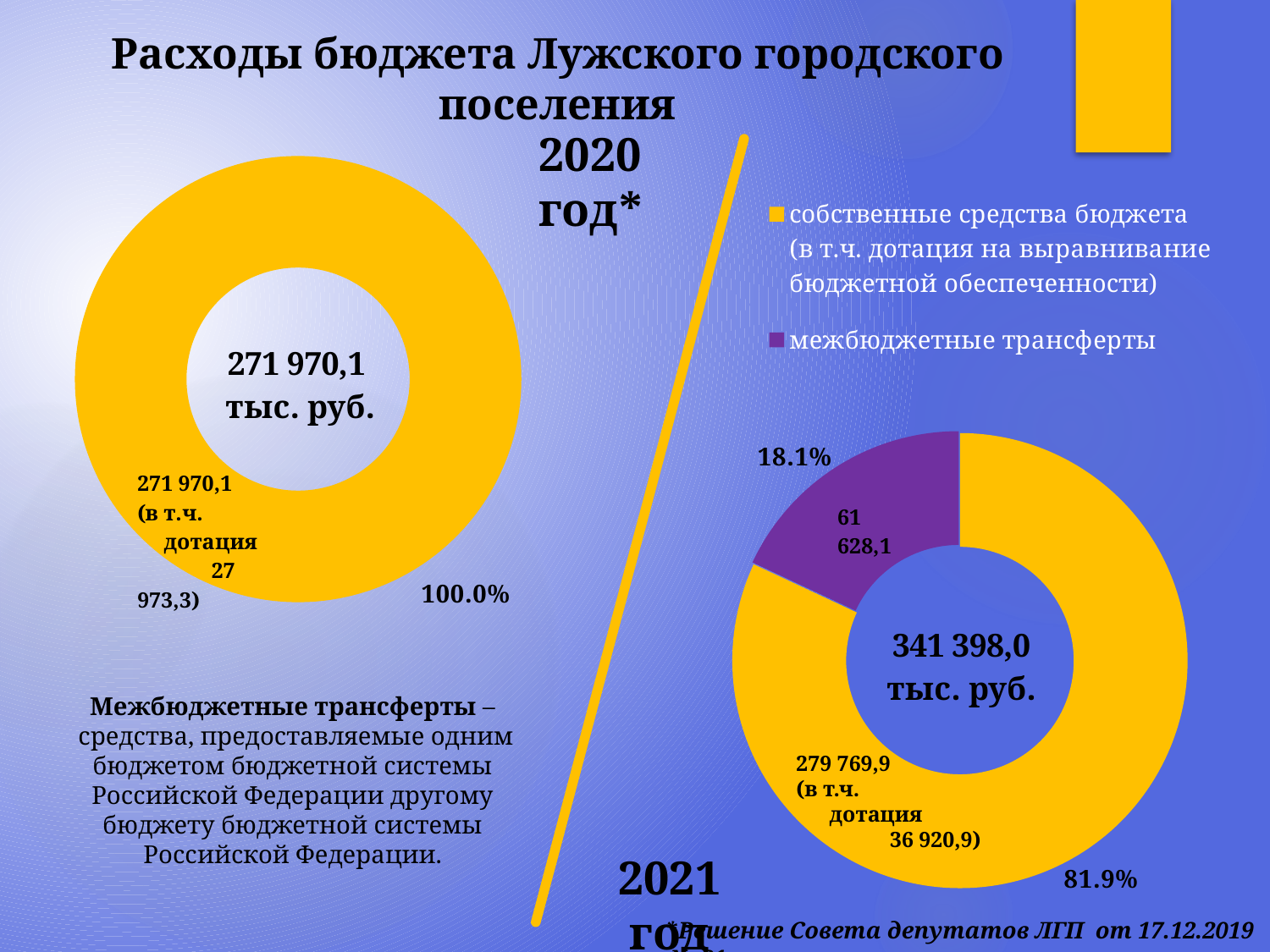
In the 2021 год chart on the right, what is the value for межбюджетные трансферты? 61 628,1 In the 2021 год chart on the right, which category is larger: собственные средства бюджета or межбюджетные трансферты? собственные средства бюджета How many series does the legend on the slide list? 2 What type of chart is used for the 2020 год data on the left of the slide? doughnut (pie) chart What total is shown in the centre of the 2020 год chart on the left? 271 970,1 тыс. руб. What total is shown in the centre of the 2021 год chart on the right? 341 398,0 тыс. руб. In the 2021 год chart on the right, what share of the budget expenses is межбюджетные трансферты? 18.1% In the 2021 год chart on the right, what share is собственные средства бюджета? 81.9% In the 2020 год chart on the left, what percentage is shown for the single slice? 100.0% In the 2021 год chart on the right, what is the value for собственные средства бюджета? 279 769,9 Which colour represents межбюджетные трансферты in the legend? purple In the 2021 год chart on the right, what is the difference between собственные средства бюджета and межбюджетные трансферты? 218 141,8